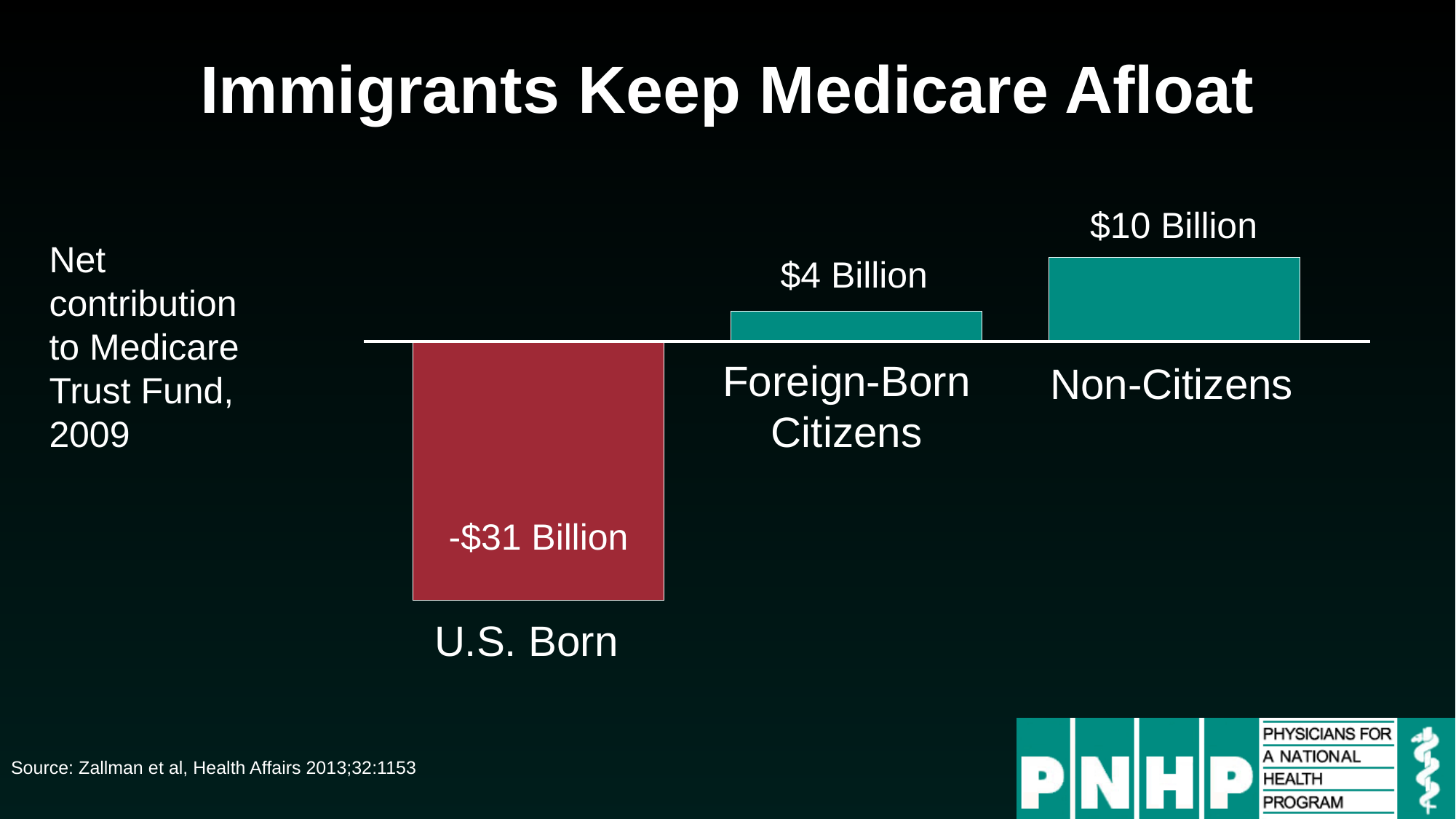
How many categories are shown in the chart? 3 What is the difference between the net contributions of Non-Citizens and Foreign-Born Citizens? $6 Billion What is the net contribution to the Medicare Trust Fund for Foreign-Born Citizens? $4 Billion What kind of chart is shown on the slide? Bar chart Which category is shown with a red bar? U.S. Born How many categories have a negative net contribution? 1 What is the net contribution to the Medicare Trust Fund for Non-Citizens? $10 Billion What year does the chart's net contribution data refer to? 2009 Which category has the lowest net contribution to the Medicare Trust Fund? U.S. Born Which has a larger net contribution, Foreign-Born Citizens or Non-Citizens? Non-Citizens Which category has the highest net contribution to the Medicare Trust Fund? Non-Citizens What is the net contribution to the Medicare Trust Fund for U.S. Born? -$31 Billion